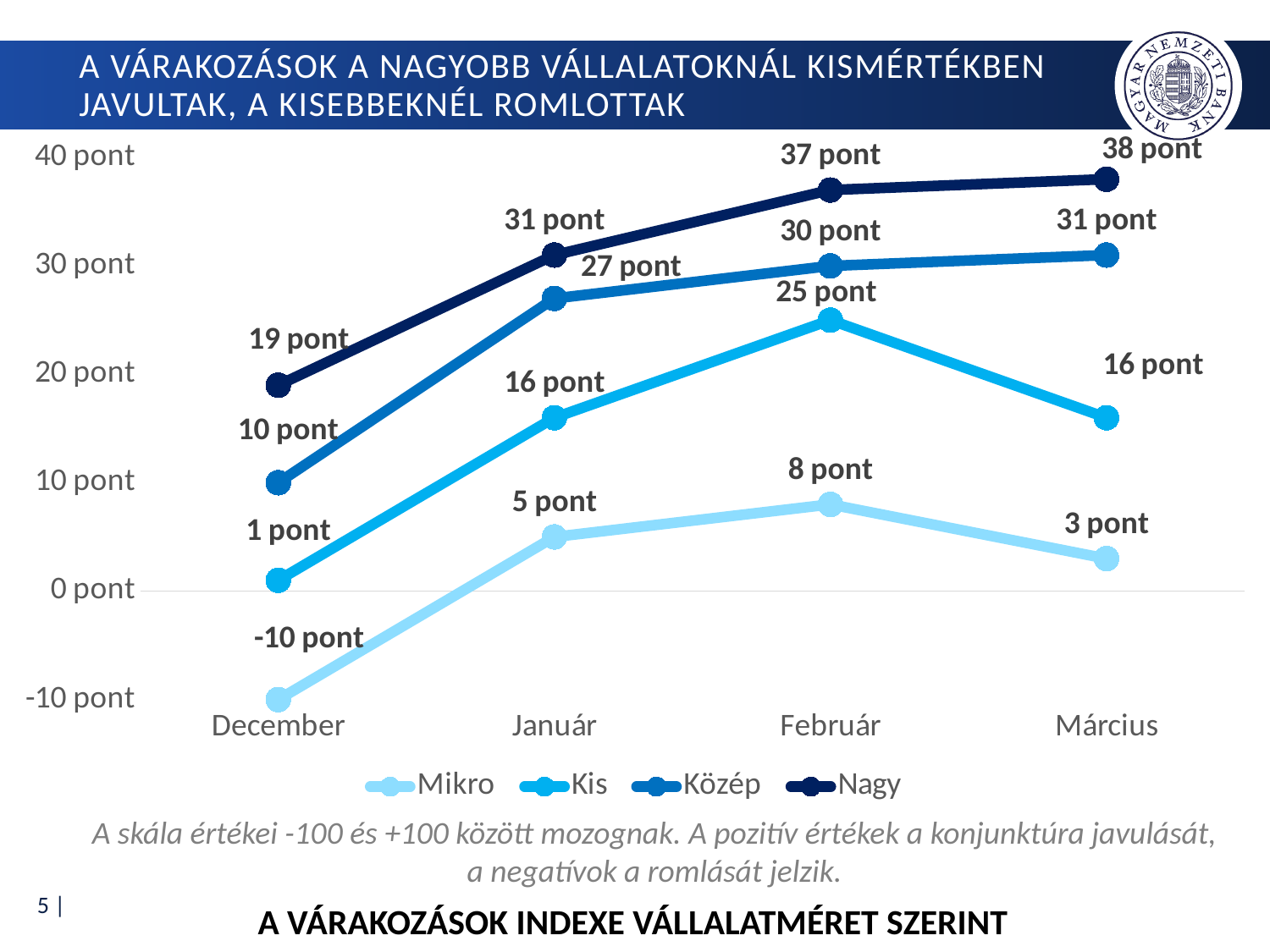
What is the value for Kis in Február? 25 pont How many months are shown on the x axis? 4 What is the value for Mikro in December? -10 pont What type of chart is shown on the slide? line chart In which month does the Kis series reach its highest value? Február What is the value for Közép in Január? 27 pont What is the difference between the Nagy and Közép values in Február? 7 pont Which is larger in Március: the Kis value or the Mikro value? Kis Which series has the lowest value in December? Mikro Does the Nagy series rise or fall from December to Március? rise How many series does the legend list? 4 What is the value for Nagy in Március? 38 pont